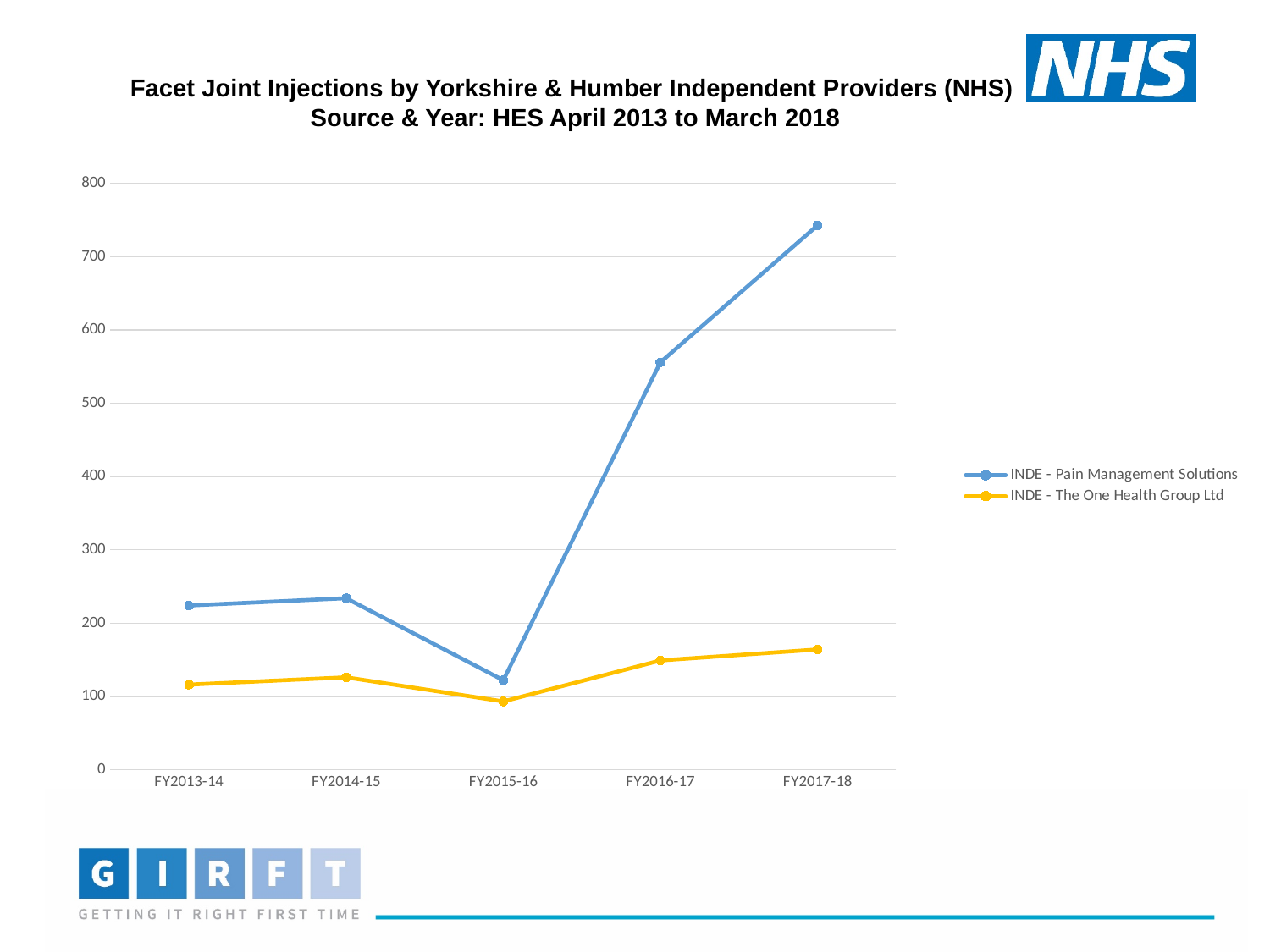
What kind of chart is shown on the slide? Line chart How many financial years are plotted along the x axis? 5 In which financial year does INDE - The One Health Group Ltd have its lowest value? FY2015-16 Is the value for INDE - Pain Management Solutions in FY2016-17 greater or less than 500? greater In FY2016-17, which series has the larger value: INDE - Pain Management Solutions or INDE - The One Health Group Ltd? INDE - Pain Management Solutions In which financial year does INDE - Pain Management Solutions have its lowest value? FY2015-16 In which financial year does INDE - Pain Management Solutions reach its highest value? FY2017-18 Is the value for INDE - The One Health Group Ltd in FY2017-18 greater or less than 200? less Is the value for INDE - Pain Management Solutions in FY2017-18 greater or less than 700? greater Does the value for INDE - The One Health Group Ltd rise or fall from FY2015-16 to FY2017-18? Rise How many series does the legend list? 2